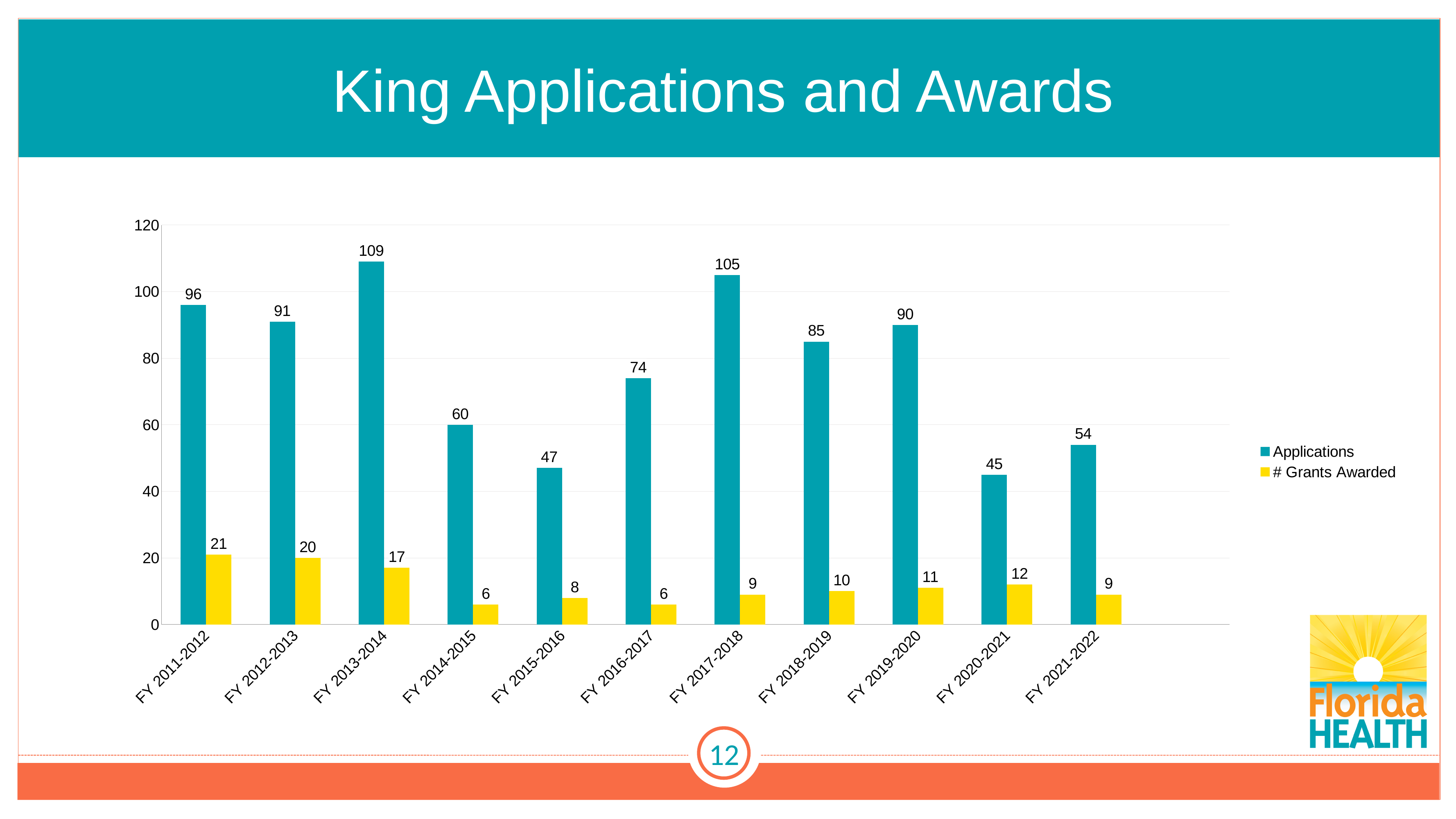
How many Applications were there in FY 2013-2014? 109 How many grants were awarded in FY 2011-2012? 21 Which fiscal years had the lowest number of grants awarded? FY 2014-2015 and FY 2016-2017 Which fiscal year had the lowest number of Applications? FY 2020-2021 What type of chart is shown on the slide? Bar chart How many fiscal years are shown on the x axis? 11 What colour are the bars for # Grants Awarded? Yellow How many series does the legend list? 2 Which fiscal year had the highest number of Applications? FY 2013-2014 What is the difference between Applications and # Grants Awarded in FY 2017-2018? 96 Which fiscal year had more Applications, FY 2018-2019 or FY 2019-2020? FY 2019-2020 How many grants were awarded in FY 2021-2022? 9